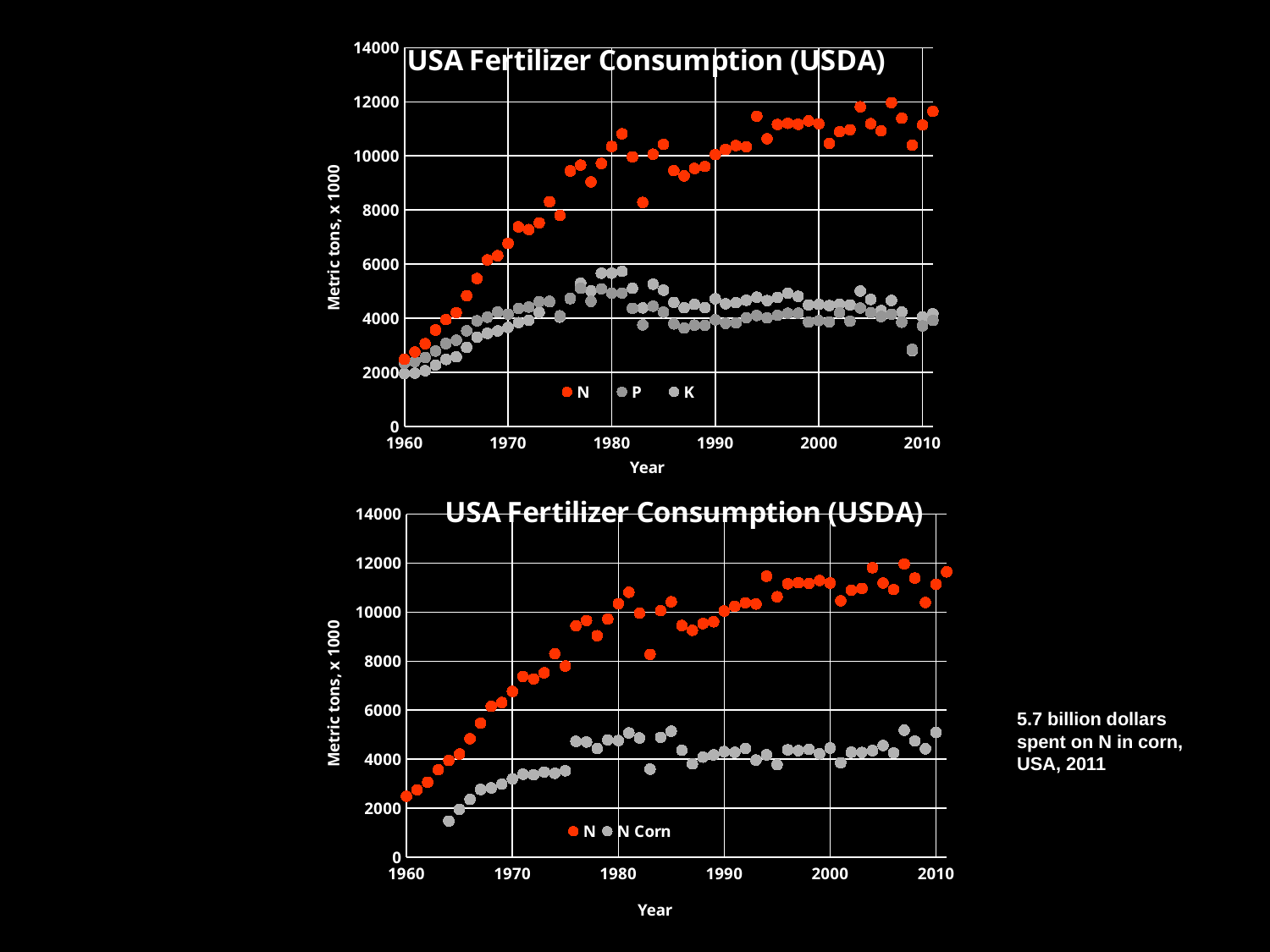
What is the y-axis label of the bottom chart? Metric tons, x 1000 In the bottom chart, which series has the larger value in 1990, N or N Corn? N In the bottom chart, is the value for N in 1980 greater or less than 8000? greater In the top chart, is the value for N in 2010 greater or less than 10000? greater What are the series names in the legend of the top chart? N, P, K How many series does the legend of the bottom chart list? 2 In the top chart, does the N series generally rise or fall from 1960 to 2010? Rise In the bottom chart, is the value for N Corn in 1965 greater or less than 4000? less What type of chart is the top chart on the slide? Scatter chart How many series does the legend of the top chart list? 3 In the top chart, which series has the larger value in 2000, N or P? N